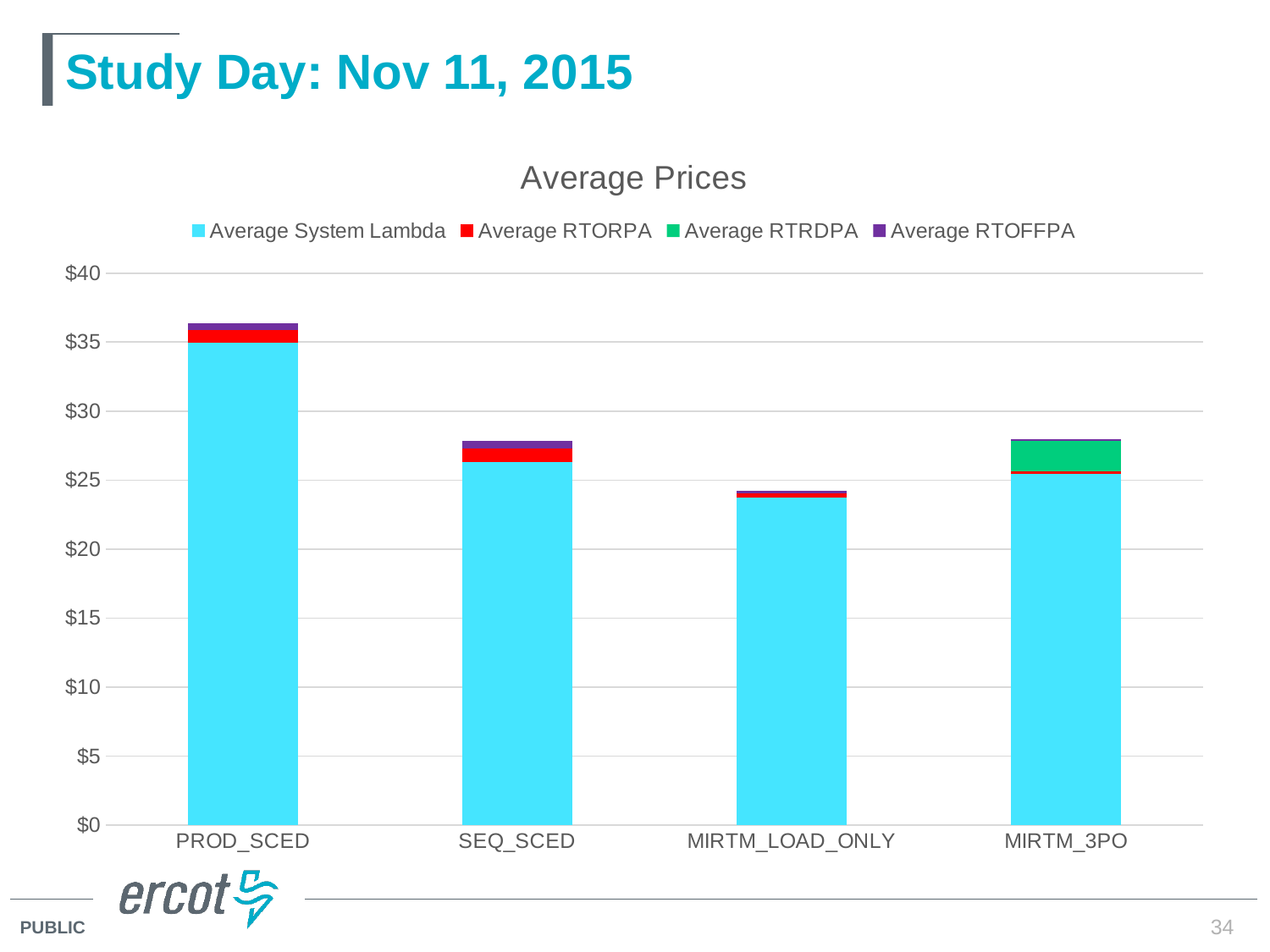
Is the total stacked value for PROD_SCED greater or less than $35? greater Is the total stacked value for MIRTM_3PO greater or less than $30? less Which category has the lowest total stacked bar? MIRTM_LOAD_ONLY What kind of chart is shown on the slide? Stacked bar chart What is the title of the chart? Average Prices How many series does the legend list? 4 Is the total stacked value for MIRTM_LOAD_ONLY greater or less than $25? less How many categories are shown on the x axis? 4 Which has the larger total stacked bar, PROD_SCED or SEQ_SCED? PROD_SCED Which category has the highest total stacked bar? PROD_SCED Which category is the only one with a visible Average RTRDPA (green) segment? MIRTM_3PO